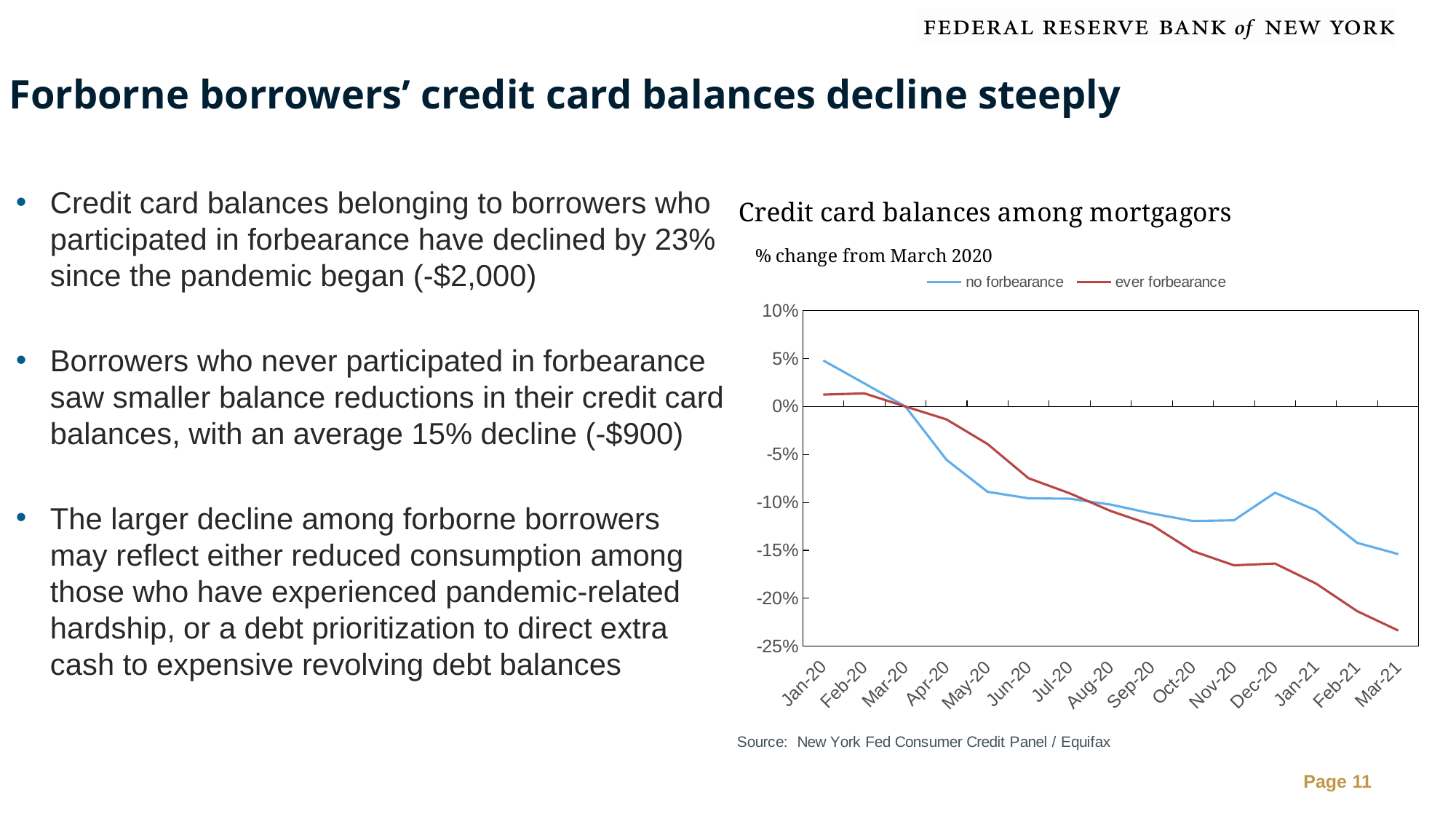
What is the title of the chart? Credit card balances among mortgagors Is the value for ever forbearance at Dec-20 greater or less than -15%? less Does the ever forbearance series rise or fall overall from Jan-20 to Mar-21? fall Is the value for ever forbearance at Mar-21 greater or less than -20%? less How many months are plotted along the x axis of the chart? 15 What kind of chart is shown on the slide? line chart What is the value for both series at Mar-20? 0% Is the value for no forbearance at Dec-20 greater or less than -10%? greater How many series does the chart legend list? 2 At Mar-21, which series has the lower value, no forbearance or ever forbearance? ever forbearance At Jan-20, which series has the higher value, no forbearance or ever forbearance? no forbearance